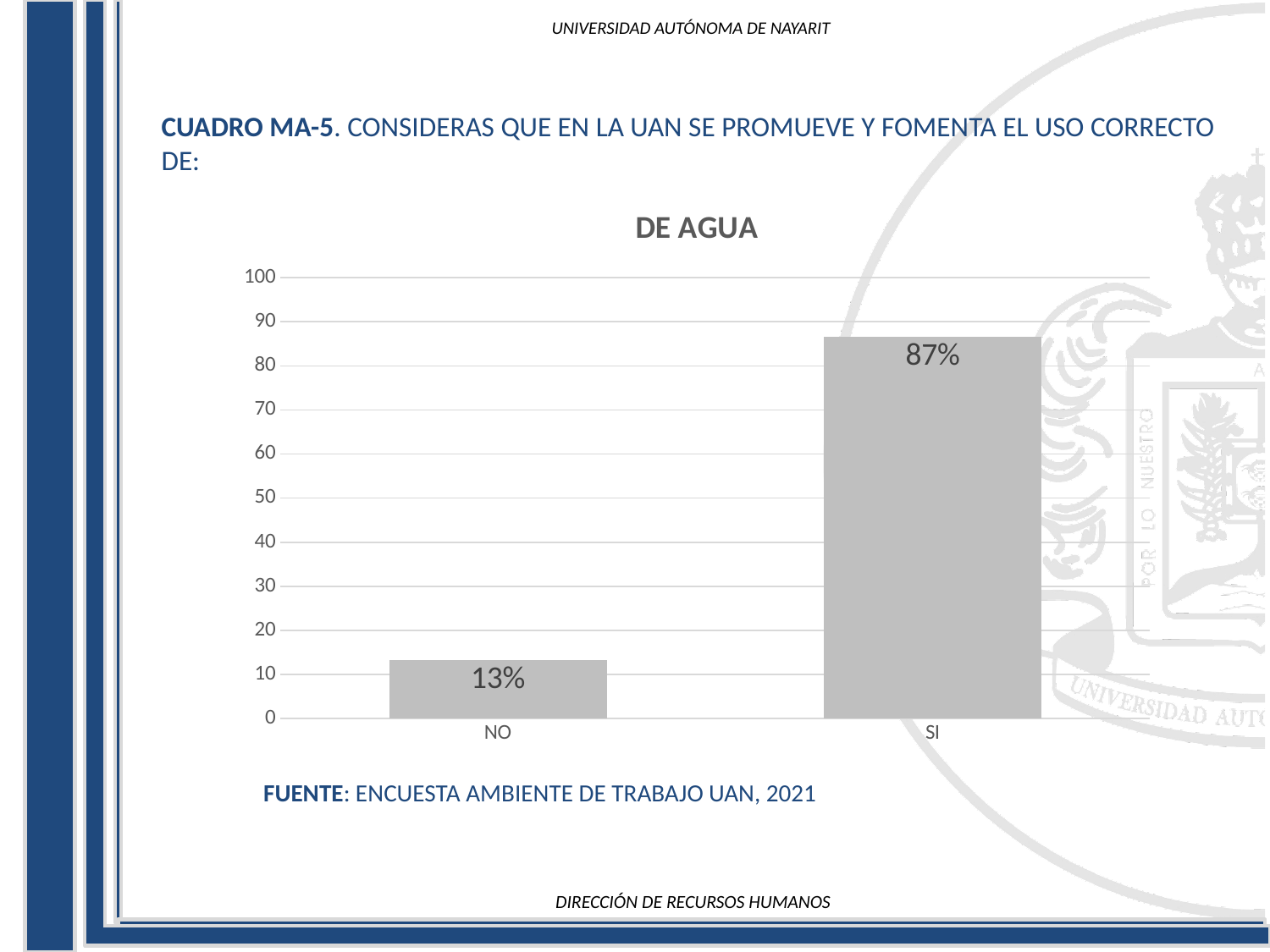
What is the highest value shown on the y axis? 100 Which category has the highest value? SI How many categories are shown on the x axis? 2 Is the value for NO greater or less than 20? less Which category has the lowest value? NO What is the difference between the values for SI and NO? 74% What is the value for SI? 87% Which is larger, the value for NO or the value for SI? SI What is the value for NO? 13% What kind of chart is shown? bar chart Is the value for SI greater or less than 80? greater What is the title of the chart? DE AGUA